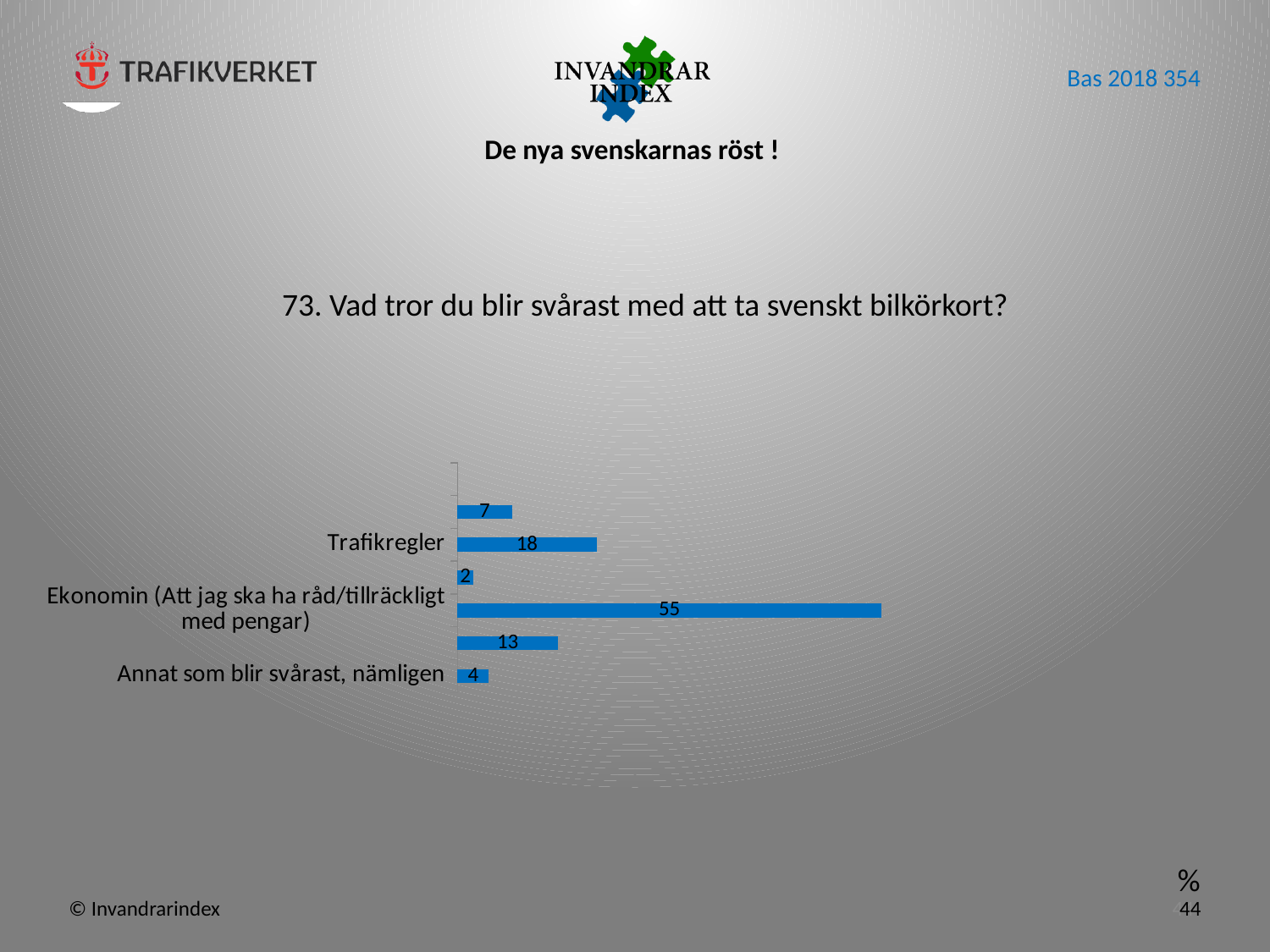
What is the value for Ekonomin (Att jag ska ha råd/tillräckligt med pengar)? 55 What is the difference between the values for Ekonomin (Att jag ska ha råd/tillräckligt med pengar) and Trafikregler? 37 What is the value for Trafikregler? 18 What kind of chart is shown on the slide? bar chart Which labelled category has the highest value? Ekonomin (Att jag ska ha råd/tillräckligt med pengar) Which is larger, the value for Trafikregler or the value for Annat som blir svårast, nämligen? Trafikregler What is the smallest value labelled on any bar in the chart? 2 What is the title of the chart on the slide? 73. Vad tror du blir svårast med att ta svenskt bilkörkort? What unit is indicated for the values in the chart? % What is the value for Annat som blir svårast, nämligen? 4 How many bars are plotted in the chart? 6 What is the largest value labelled on any bar in the chart? 55